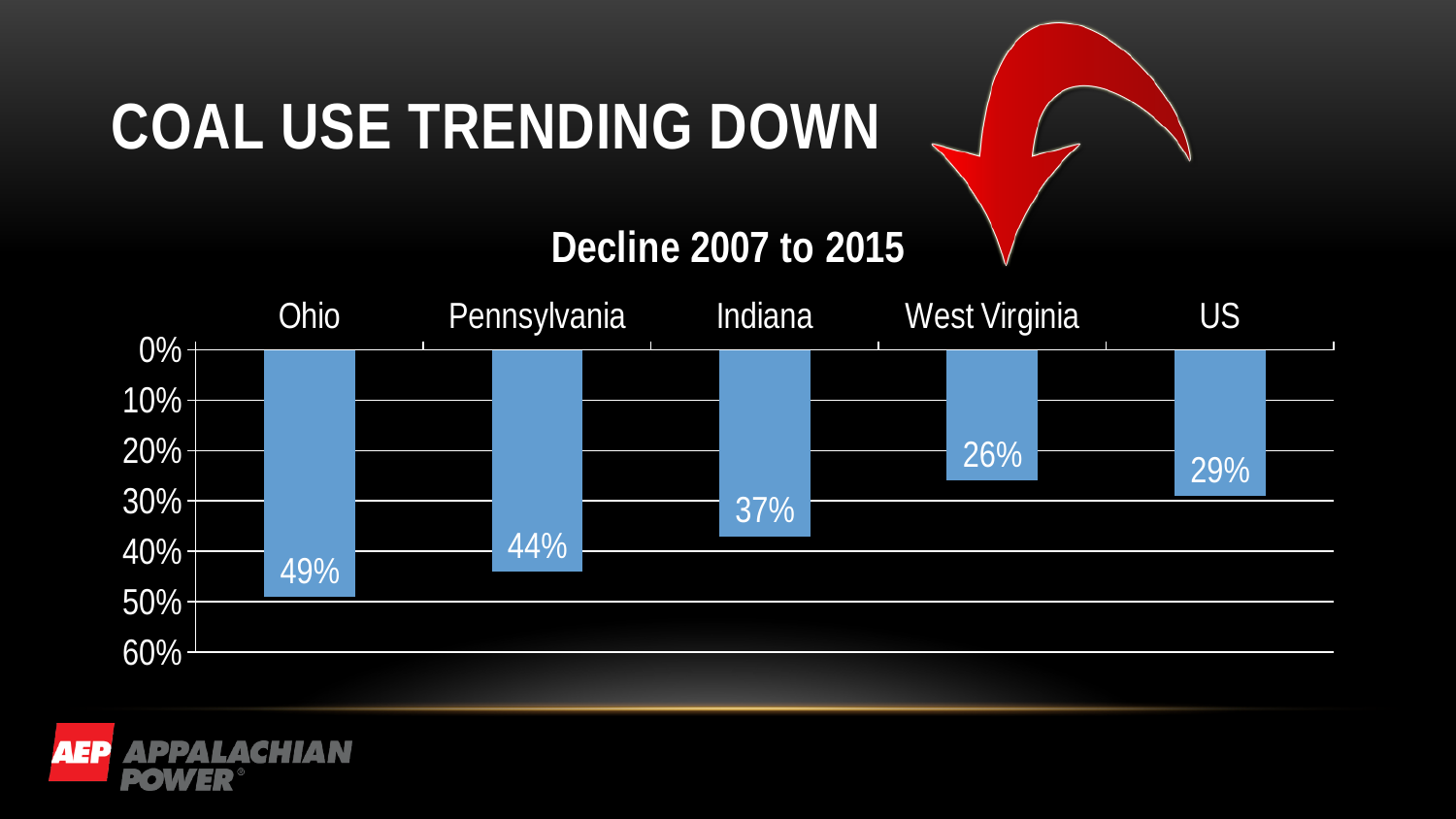
What kind of chart is shown on the slide? Bar chart Which category shows the smallest decline? West Virginia Which has a larger decline, Pennsylvania or Indiana? Pennsylvania What is the decline value shown for the US? 29% Is the decline for Indiana greater or less than 30%? greater What is the decline value shown for West Virginia? 26% What is the difference between the decline for Ohio and the decline for Pennsylvania? 5% How many categories are shown on the chart? 5 Which category shows the largest decline? Ohio What is the title of the chart? Decline 2007 to 2015 What is the difference between the decline for Indiana and the decline for the US? 8% What is the decline value shown for Ohio? 49%